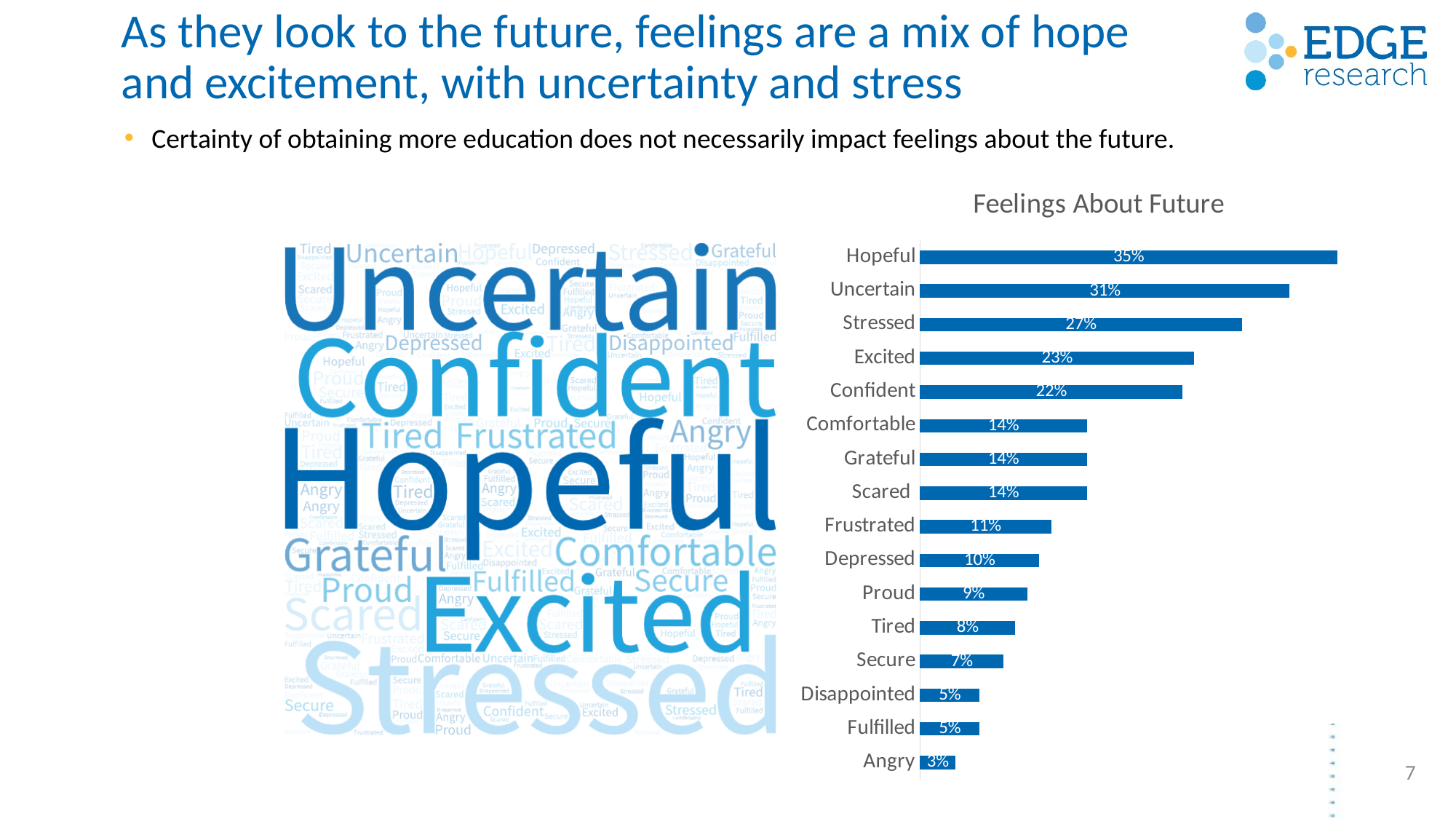
What is the value for Hopeful in the Feelings About Future chart? 35% Which feeling has the lowest value in the Feelings About Future chart? Angry What kind of chart is the Feelings About Future chart? Bar chart What is the difference between the values for Excited and Tired in the Feelings About Future chart? 15% What is the value for Stressed in the Feelings About Future chart? 27% What is the title of the bar chart on the slide? Feelings About Future In the Feelings About Future chart, which is larger, the value for Frustrated or the value for Secure? Frustrated What is the value for Depressed in the Feelings About Future chart? 10% What is the difference between the values for Hopeful and Uncertain in the Feelings About Future chart? 4% How many feelings are listed in the Feelings About Future chart? 16 In the Feelings About Future chart, which is larger, the value for Confident or the value for Comfortable? Confident Which feeling has the highest value in the Feelings About Future chart? Hopeful